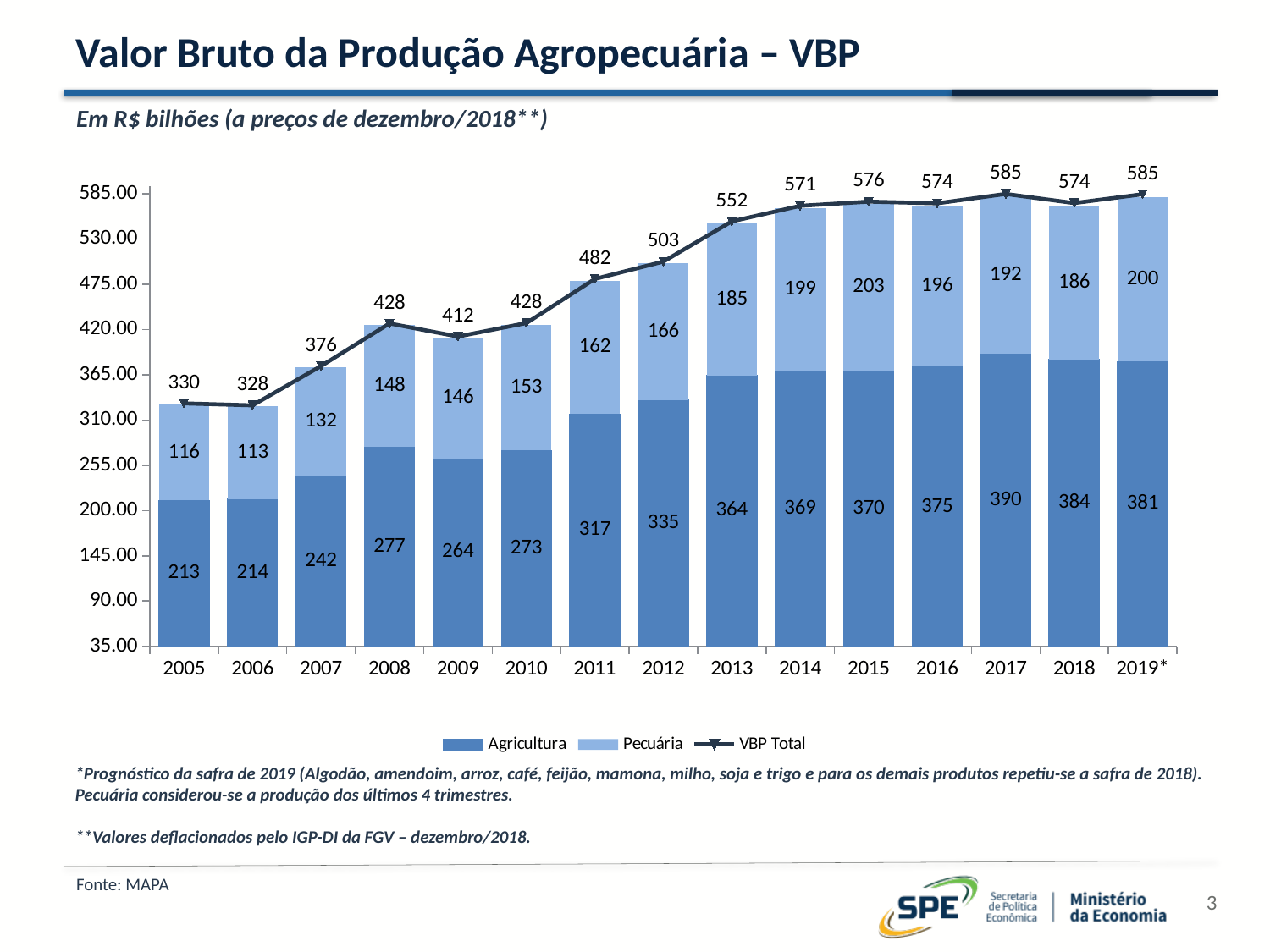
What is the VBP Total value for 2013? 552 What is the Pecuária value for 2014? 199 What is the difference between the Pecuária values for 2019* and 2018? 14 How many years are shown on the x axis? 15 Which year has the lowest Pecuária value? 2006 Which year has the highest Agricultura value? 2017 Which is larger in 2012, the Agricultura value or the Pecuária value? Agricultura How many series does the legend list? 3 What is the Agricultura value for 2008? 277 Does the VBP Total line generally rise or fall from 2005 to 2019*? rise What kind of chart is shown on the slide? combination stacked bar and line chart What is the difference between the Agricultura values for 2017 and 2005? 177